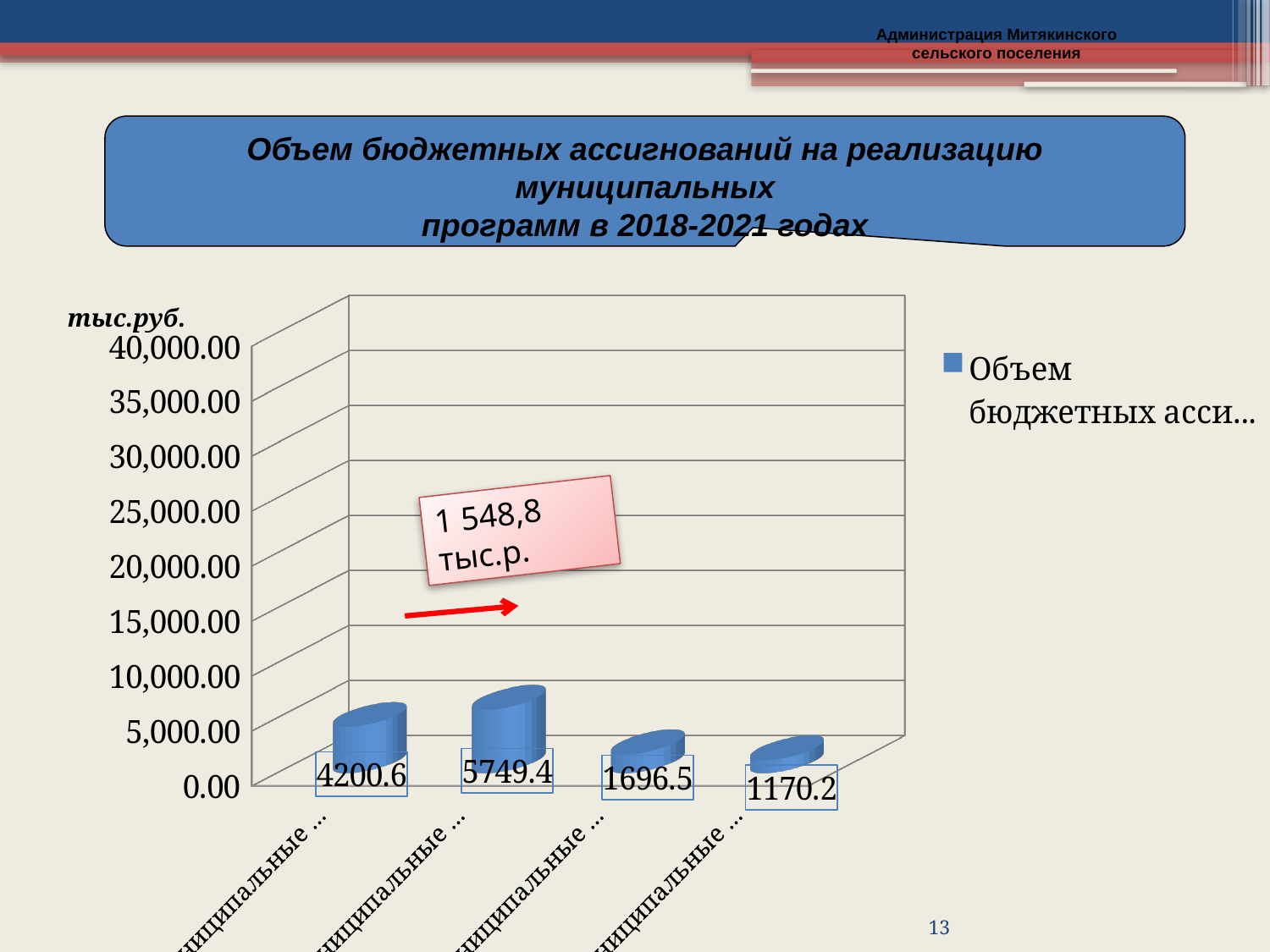
What type of chart is shown on the slide? bar chart Is the value of the second bar greater or less than 5,000.00? greater What is the data label on the first (leftmost) bar of the chart? 4200.6 What unit label is shown above the vertical axis of the chart? тыс.руб. Which bar has the highest value: the first, second, third or fourth from the left? second What is the difference between the second bar's value (5749.4) and the first bar's value (4200.6)? 1548.8 How many bars are plotted in the chart? 4 What is the data label on the second bar from the left? 5749.4 Which bar has the lowest value: the first, second, third or fourth from the left? fourth What is the data label on the fourth (rightmost) bar? 1170.2 Which is larger, the value of the third bar (1696.5) or the fourth bar (1170.2)? the third bar (1696.5) What is the data label on the third bar from the left? 1696.5